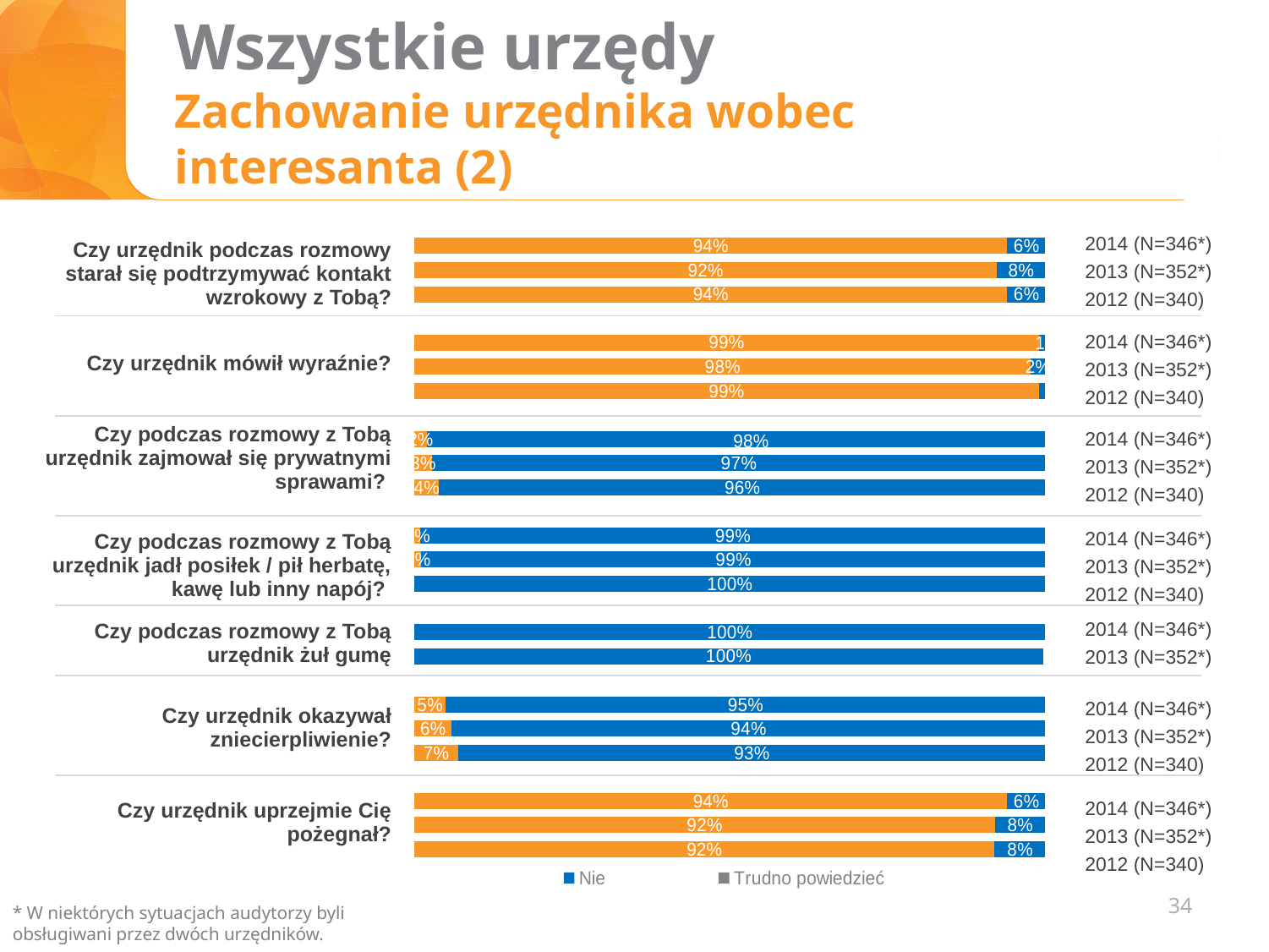
What type of chart is shown on the slide? Stacked horizontal bar chart In the row "Czy urzędnik okazywał zniecierpliwienie?", which year has the highest "Nie" (blue) value? 2014 How many years are shown for the row "Czy podczas rozmowy z Tobą urzędnik żuł gumę"? 2 What is the orange segment value for 2012 in the row "Czy urzędnik okazywał zniecierpliwienie?"? 7% What is the "Nie" (blue) value for 2012 in the row "Czy podczas rozmowy z Tobą urzędnik jadł posiłek / pił herbatę, kawę lub inny napój?"? 100% In the row "Czy urzędnik mówił wyraźnie?", is the orange segment value for 2013 larger or smaller than for 2014? smaller What is the "Nie" (blue) value for 2013 in the row "Czy urzędnik podczas rozmowy starał się podtrzymywać kontakt wzrokowy z Tobą?"? 8% In the row "Czy urzędnik uprzejmie Cię pożegnał?", which year has the lowest "Nie" (blue) value? 2014 How many entries are visible in the chart legend? 2 What is the "Nie" (blue) value for 2012 in the row "Czy podczas rozmowy z Tobą urzędnik zajmował się prywatnymi sprawami?"? 96% What is the value of the orange segment for 2014 in the row "Czy urzędnik podczas rozmowy starał się podtrzymywać kontakt wzrokowy z Tobą?"? 94% In the row "Czy urzędnik uprzejmie Cię pożegnał?", what is the difference between the orange segment values for 2014 and 2013? 2 percentage points